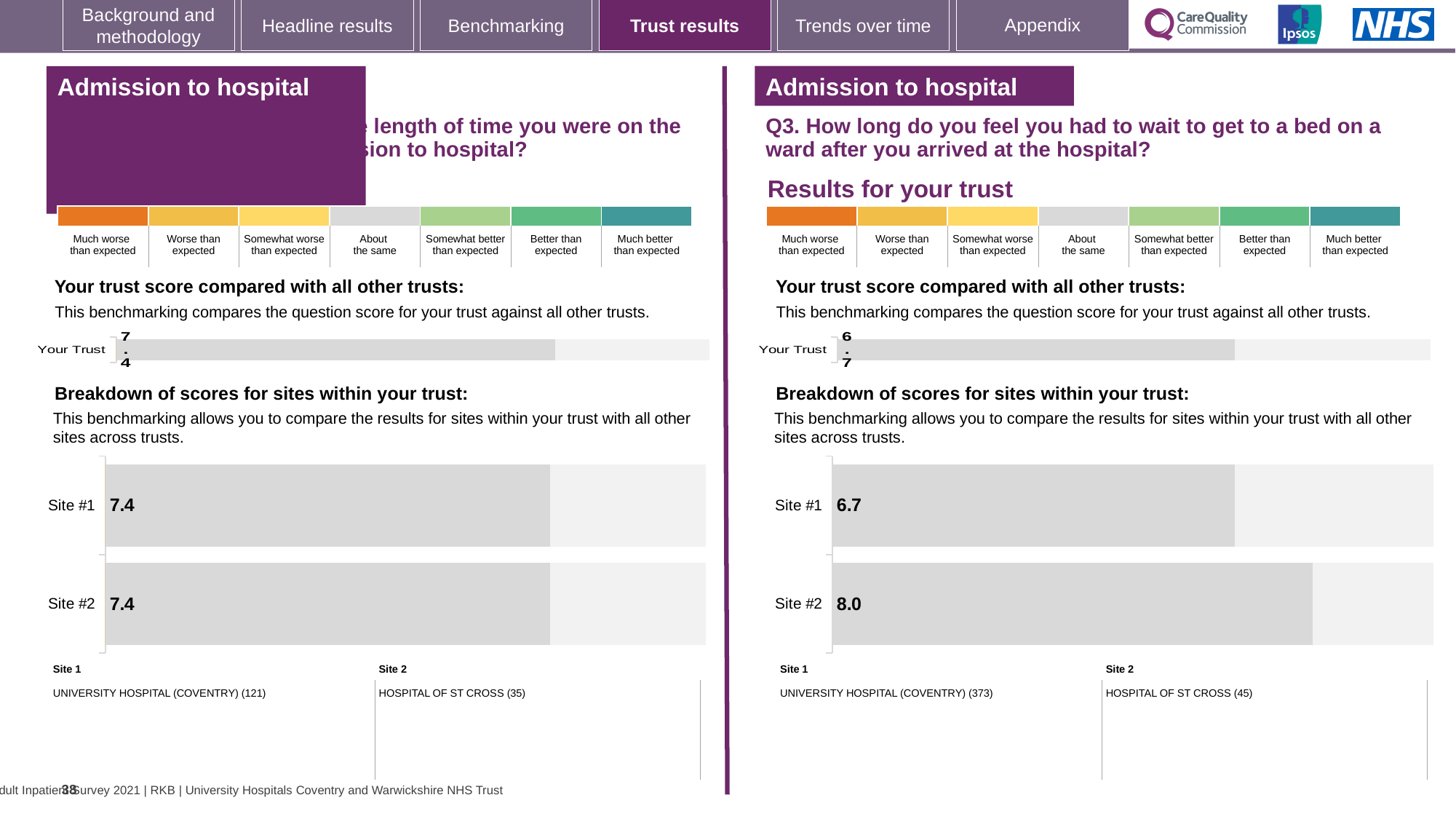
On the right-hand (Q3) 'Breakdown of scores for sites within your trust' chart, what is the score for Site #2? 8.0 On the left-hand 'Breakdown of scores for sites within your trust' chart, what is the score for Site #2? 7.4 On the right-hand (Q3) 'Breakdown of scores for sites within your trust' chart, what is the score for Site #1? 6.7 On the right-hand (Q3) site breakdown chart, is the score for Site #2 larger or smaller than the score for Site #1? larger On the left-hand 'Your trust score compared with all other trusts' chart, what is the score shown for Your Trust? 7.4 On the right-hand (Q3) site breakdown chart, which site has the higher score? Site #2 What type of chart is the right-hand (Q3) 'Breakdown of scores for sites within your trust' chart? bar chart On the right-hand (Q3) 'Your trust score compared with all other trusts' chart, what is the score shown for Your Trust? 6.7 How many sites are shown on the left-hand 'Breakdown of scores for sites within your trust' chart? 2 On the right-hand (Q3) site breakdown chart, what is the difference between the Site #2 score and the Site #1 score? 1.3 On the left-hand 'Breakdown of scores for sites within your trust' chart, what is the score for Site #1? 7.4 On the right-hand (Q3) site breakdown chart, which site has the lower score? Site #1